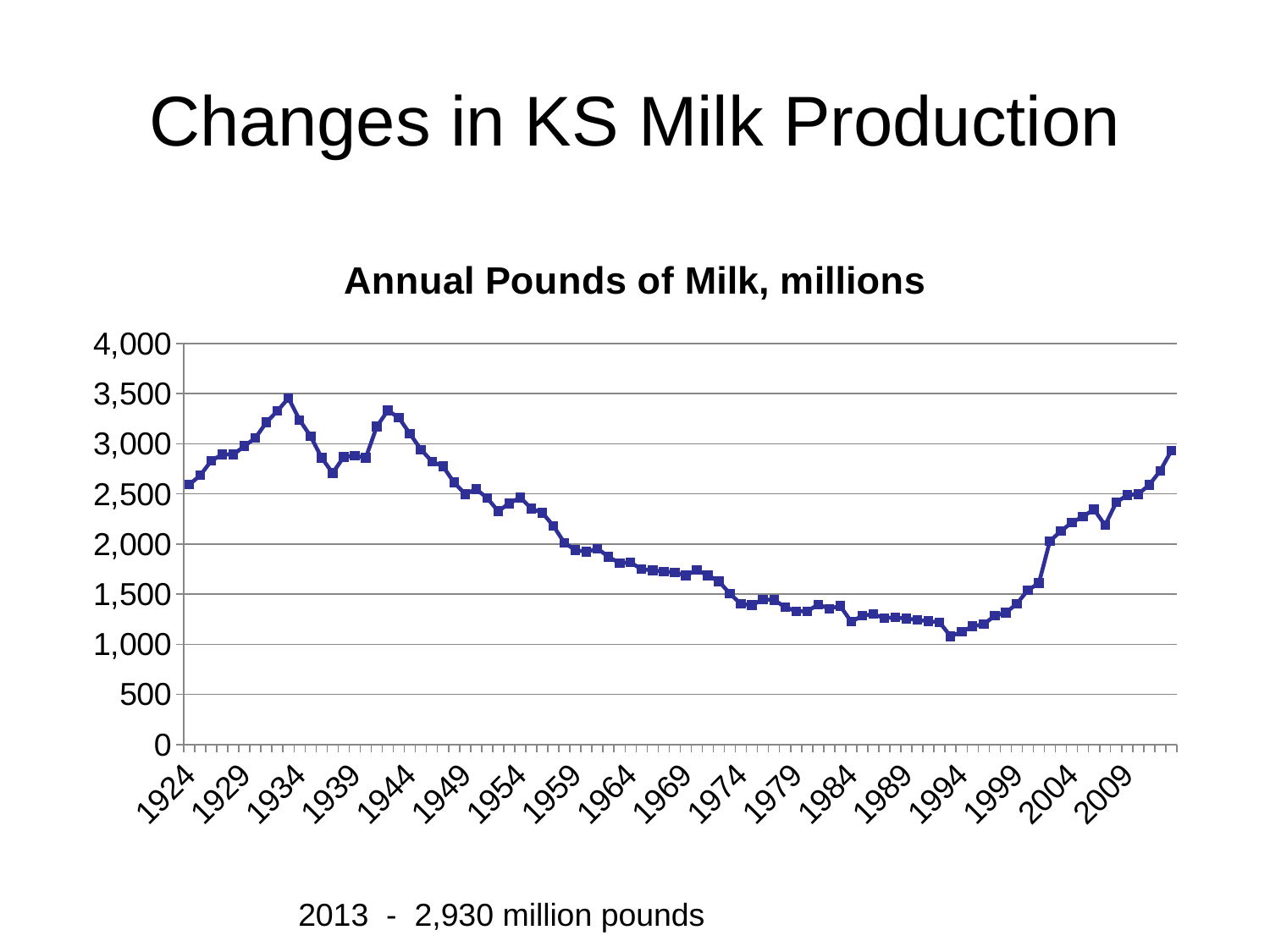
Around which labelled year does milk production reach its highest point? 1934 How many year labels are shown on the x axis? 18 What is the title of the chart? Annual Pounds of Milk, millions Around which labelled year does milk production reach its lowest point? 1994 Do the values rise or fall between 1944 and 1994? fall Which year has the larger value, 1934 or 1994? 1934 Is the value for 1964 greater or less than 2,000? less What is the highest value shown on the y axis? 4,000 Is the value for 1994 greater or less than 1,500? less Is the value for 2004 greater or less than 2,000? greater What kind of chart is shown on the slide? line chart